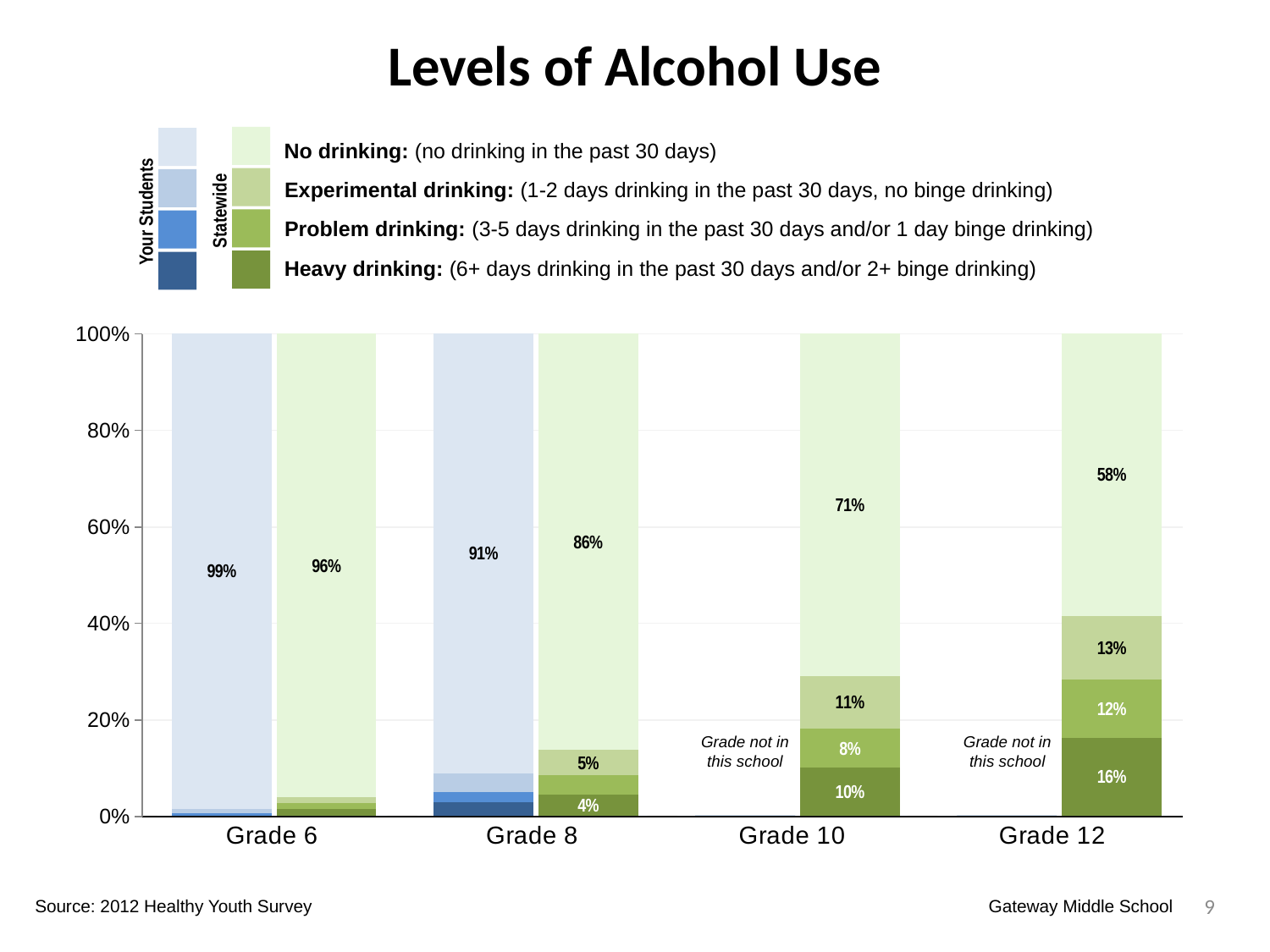
What is the Statewide no drinking percentage for Grade 8? 86% How does the Statewide no drinking percentage change from Grade 6 to Grade 12? It falls What text appears in place of the Your Students bar for Grade 10? Grade not in this school What is the Statewide heavy drinking percentage for Grade 12? 16% What is the Statewide experimental drinking percentage for Grade 12? 13% For Grade 8, which group has the higher no drinking percentage, Your Students or Statewide? Your Students By how many percentage points does the Grade 6 no drinking value for Your Students exceed the Statewide value? 3 percentage points How many grade categories are shown on the x axis? 4 What percentage of Your Students in Grade 6 reported no drinking? 99% Which grade has the highest Statewide heavy drinking percentage? Grade 12 What is the Statewide problem drinking percentage for Grade 10? 8% What kind of chart is shown on the slide? Stacked bar chart